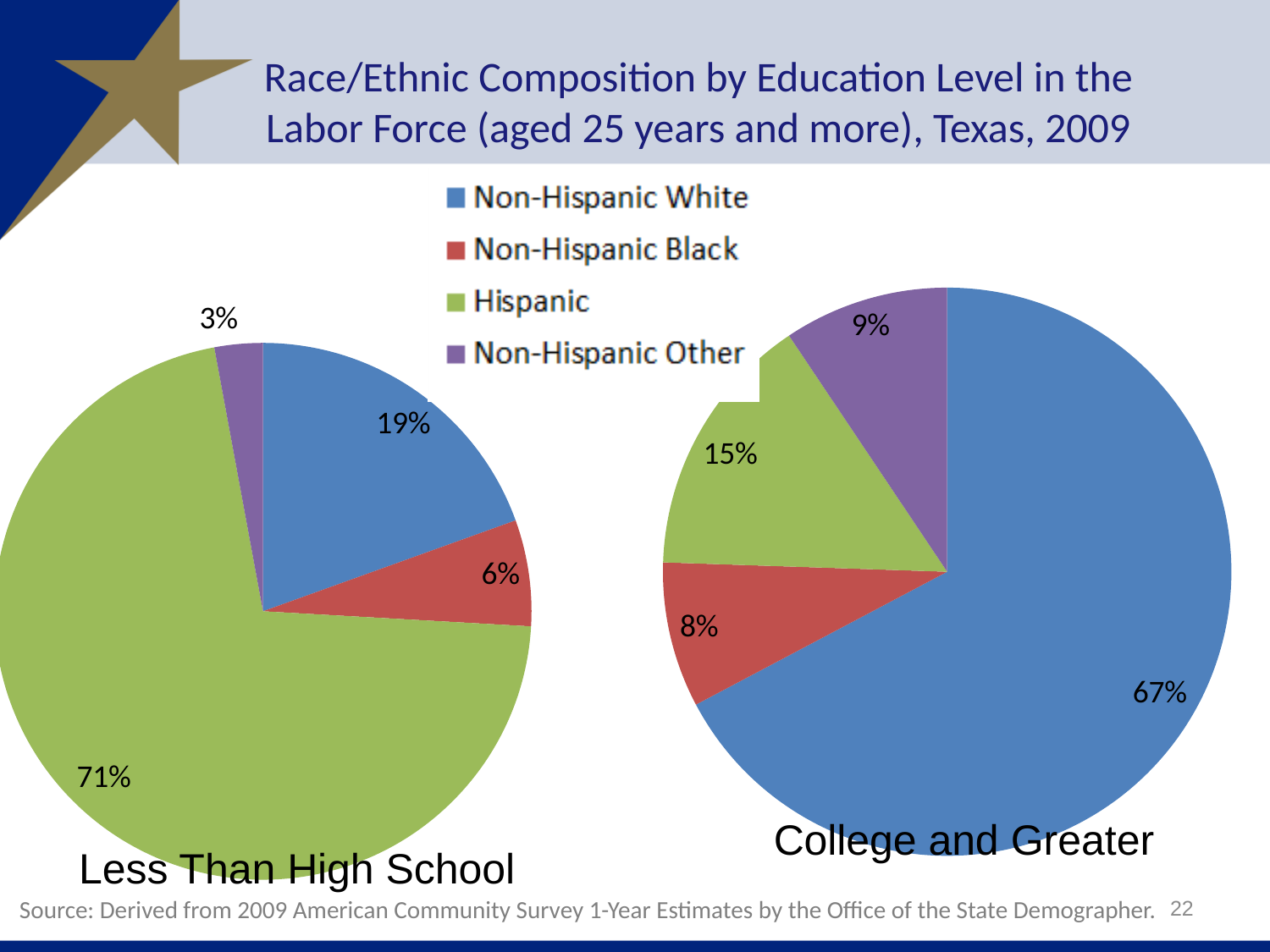
How many entries does the legend list? 4 How many slices does the College and Greater pie chart have? 4 In the College and Greater pie chart, what share is Non-Hispanic White? 67% In the Less Than High School pie chart, which group has the smallest share? Non-Hispanic Other In the College and Greater pie chart, which group has the smallest share? Non-Hispanic Black In the College and Greater pie chart, what share is Non-Hispanic Other? 9% In the Less Than High School pie chart, what share is Non-Hispanic Black? 6% Is the Hispanic share larger in the Less Than High School chart or the College and Greater chart? Less Than High School In the Less Than High School pie chart, what share is Hispanic? 71% What is the difference between the Non-Hispanic White share in the College and Greater chart and in the Less Than High School chart? 48 percentage points What type of chart is used for the Less Than High School data? Pie chart In the Less Than High School pie chart, which group has the largest share? Hispanic